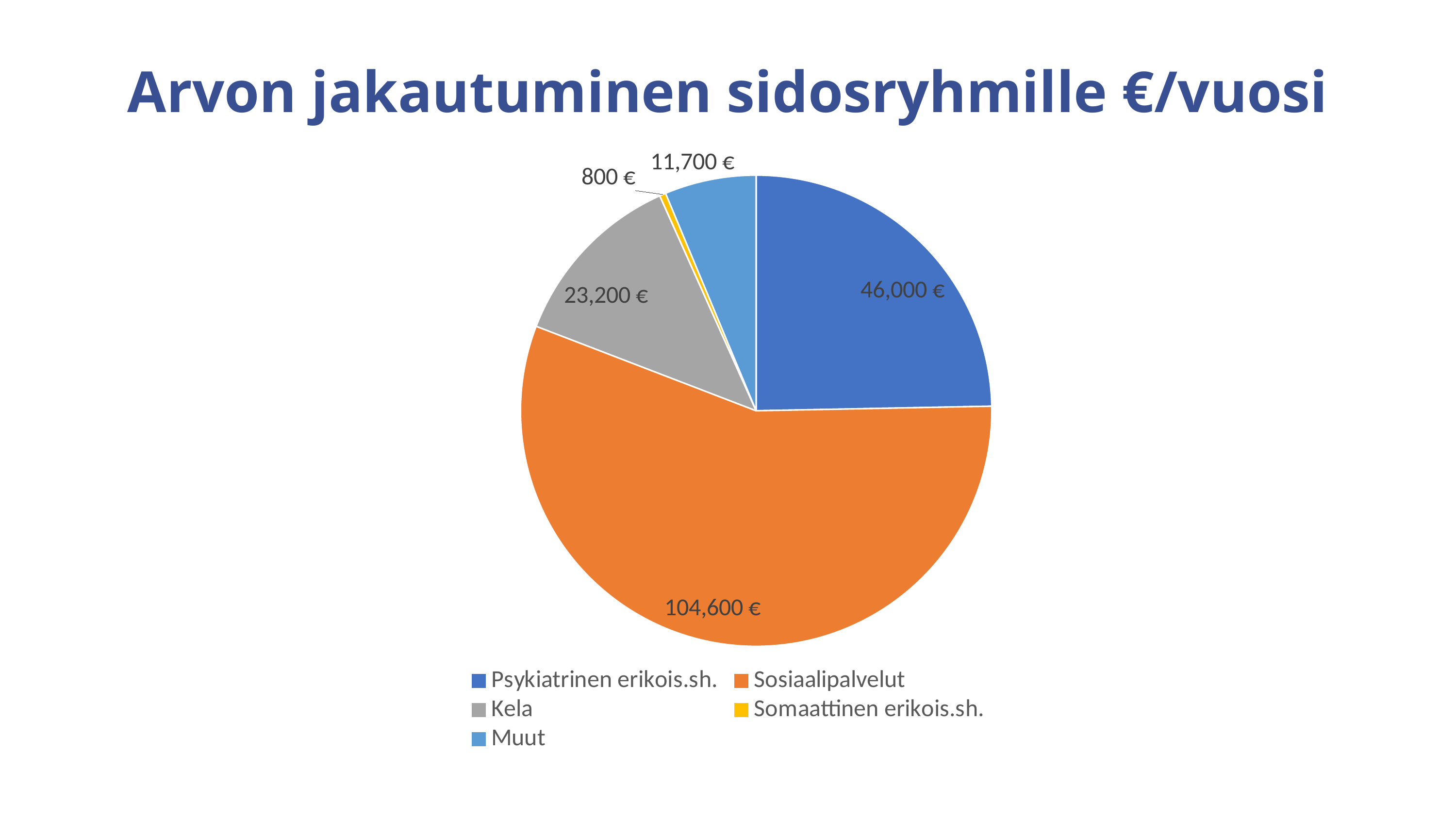
What value is shown for Muut? 11,700 € How many categories does the pie chart show? 5 Which category has the largest slice of the pie? Sosiaalipalvelut What value is shown for Sosiaalipalvelut? 104,600 € Which is larger, the value for Kela or the value for Muut? Kela What is the difference between the values for Sosiaalipalvelut and Psykiatrinen erikois.sh.? 58,600 € What is the title of the chart? Arvon jakautuminen sidosryhmille €/vuosi What kind of chart is shown on the slide? Pie chart What value is shown for Somaattinen erikois.sh.? 800 € What value is shown for Psykiatrinen erikois.sh.? 46,000 € What value is shown for Kela? 23,200 € Which category has the smallest slice of the pie? Somaattinen erikois.sh.